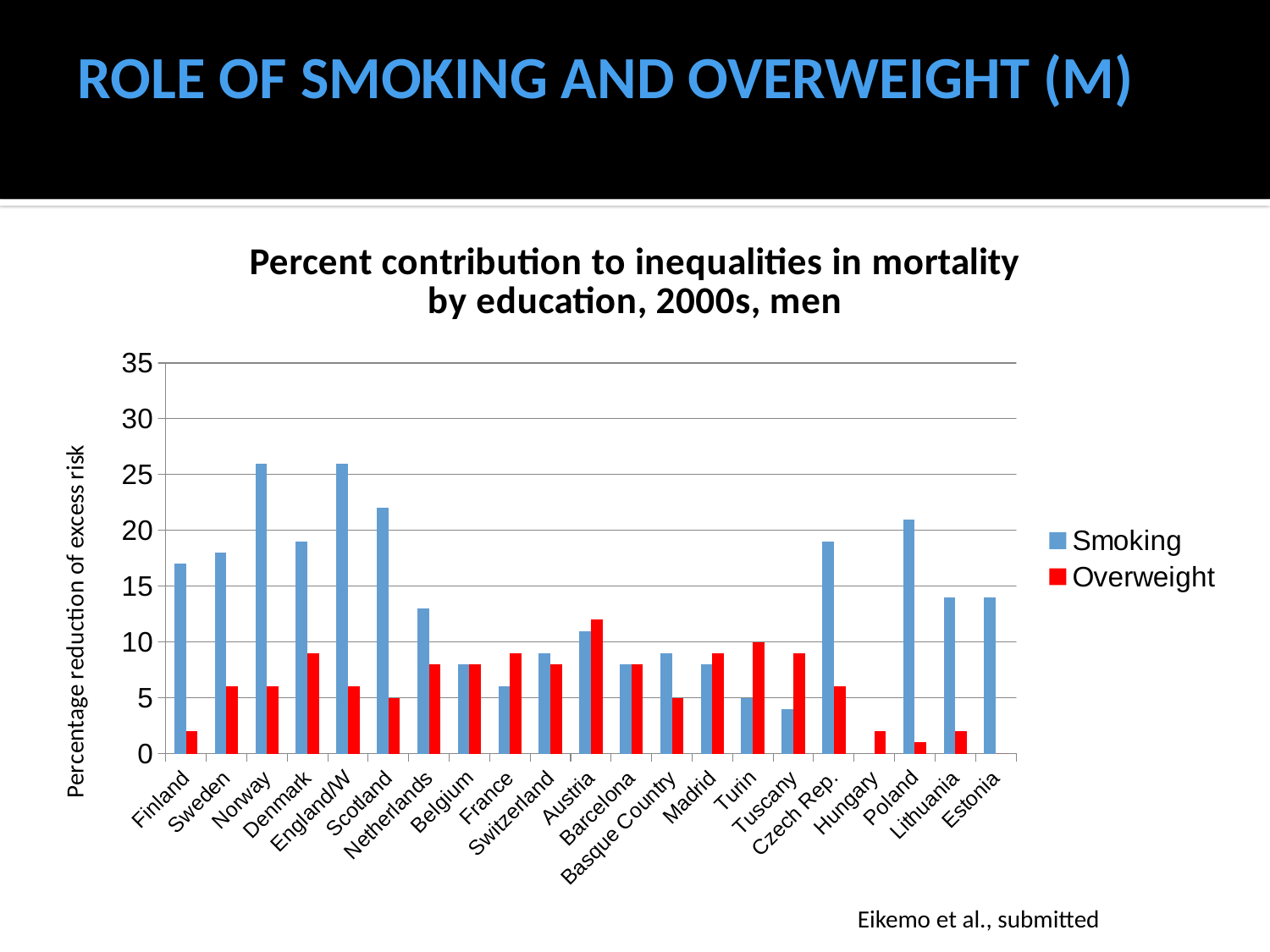
How many countries or regions are shown on the x axis? 21 Is the Smoking value for Scotland greater or less than 20? greater Is the Overweight value for Finland greater or less than 5? less For Turin, which is larger: the Smoking value or the Overweight value? Overweight What kind of chart is shown on the slide? bar chart Which has the larger Smoking value: Norway or Scotland? Norway Is the Smoking value for Netherlands greater or less than 15? less What is the title of the chart? Percent contribution to inequalities in mortality by education, 2000s, men How many series does the legend list? 2 Which category has the highest Overweight value? Austria Which colour represents the Overweight series? red